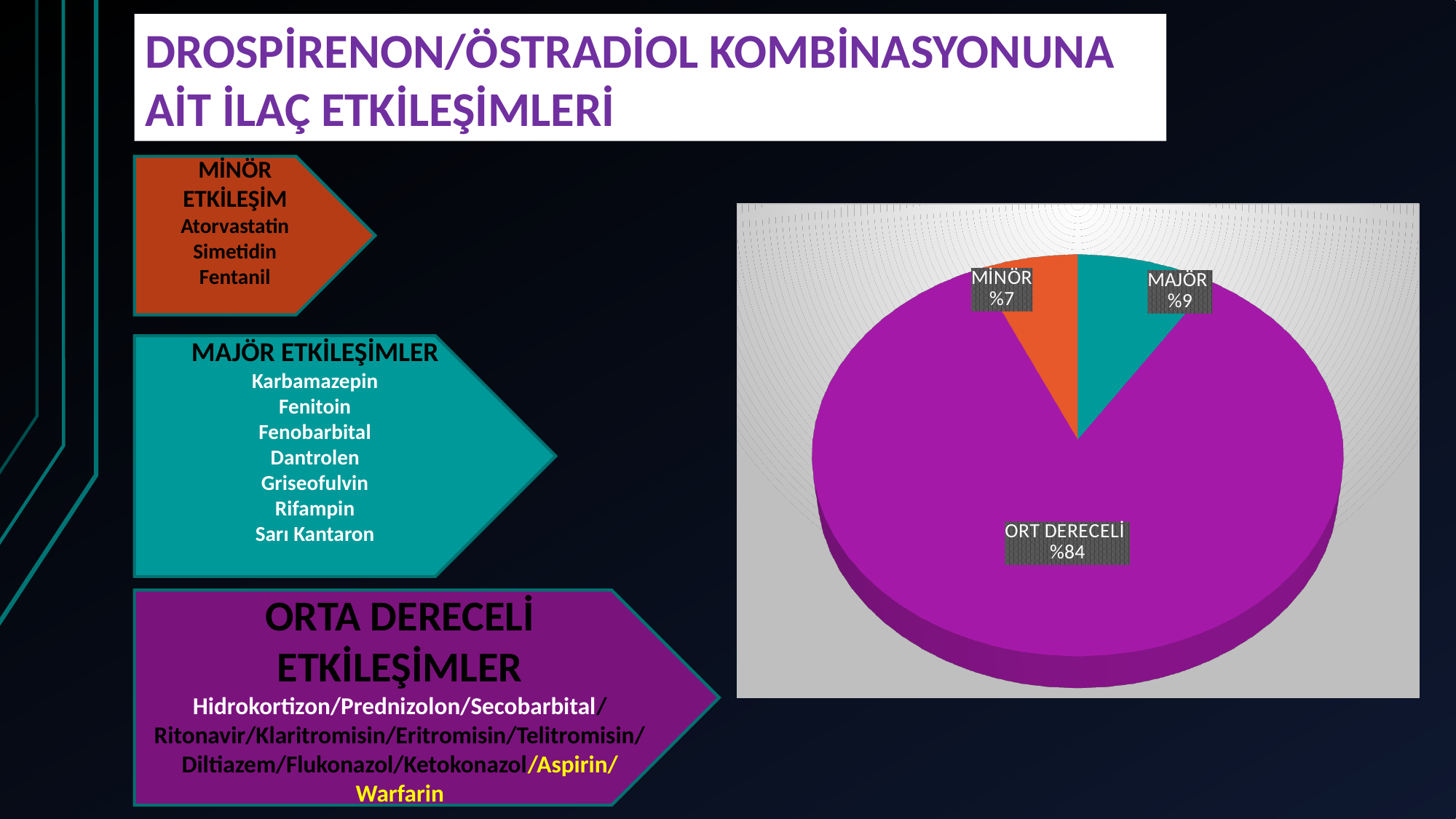
What colour is the ORT DERECELİ slice of the pie chart? purple What kind of chart is shown on the slide? pie chart What is the difference in percentage points between the ORT DERECELİ slice and the MAJÖR slice? 75 How many slices does the pie chart have? 3 Which is larger, the MAJÖR slice or the MİNÖR slice? MAJÖR Which slice of the pie chart is the smallest? MİNÖR What share of the pie does the MİNÖR slice represent? %7 What share of the pie does the ORT DERECELİ slice represent? %84 Which slice of the pie chart is the largest? ORT DERECELİ What share of the pie does the MAJÖR slice represent? %9 What colour is the MAJÖR slice of the pie chart? teal What is the difference in percentage points between the MAJÖR slice and the MİNÖR slice? 2